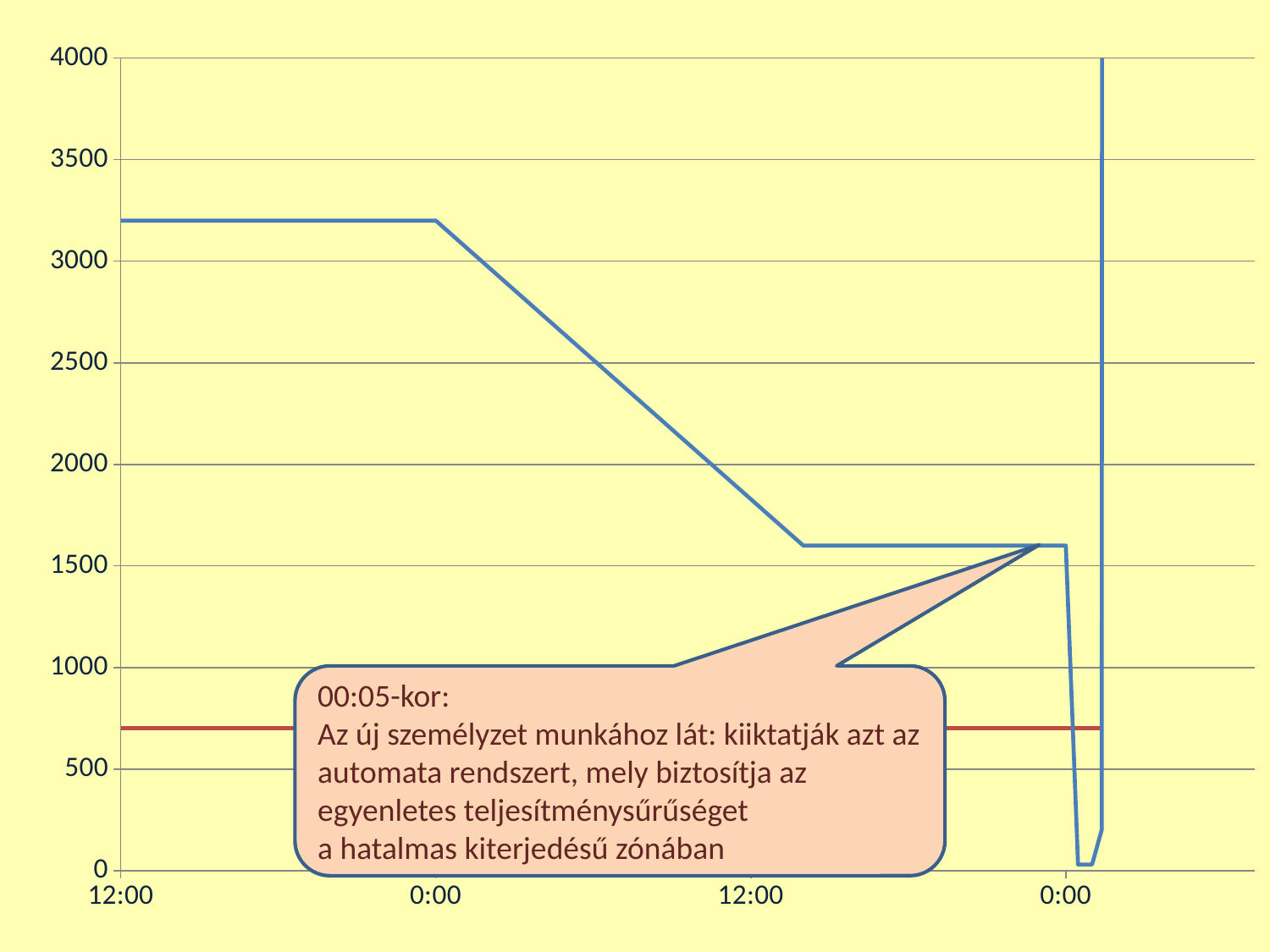
How many time labels are shown on the x axis? 4 Is the value of the red horizontal line greater or less than 1000? less What time is given at the start of the callout text on the chart? 00:05-kor Is the value of the blue line at the second 12:00 tick greater or less than 2000? less Is the value of the blue line at the second 12:00 tick greater or less than 1500? greater What kind of chart is shown on the slide? line chart Which is larger: the blue line's value at the first 12:00 tick or at the second 12:00 tick? the first 12:00 tick What is the highest value shown on the y axis? 4000 Does the blue line rise or fall between the first 0:00 tick and the second 12:00 tick? fall